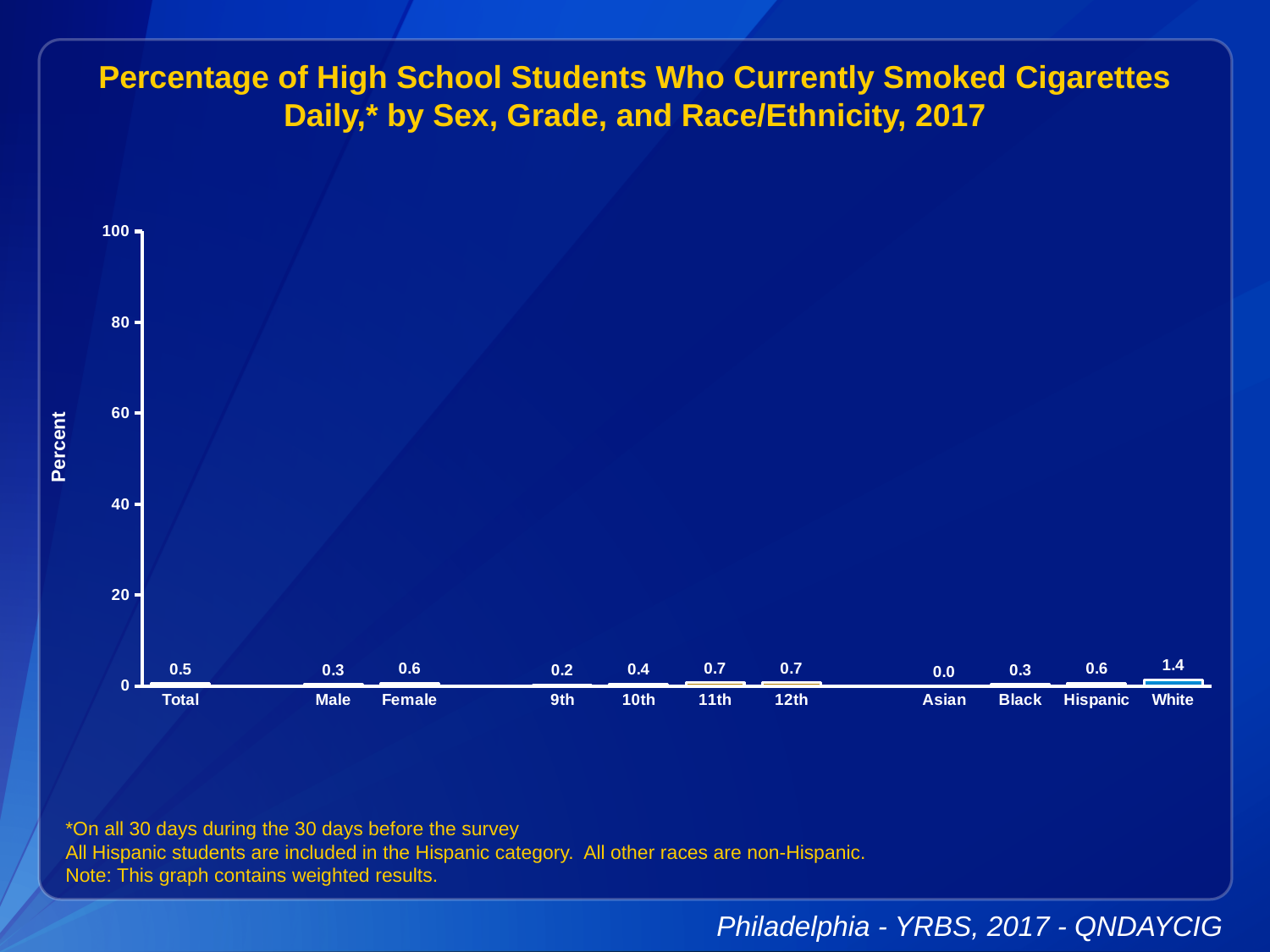
What is the value for Female? 0.6 What is the difference between the values for Female and Male? 0.3 What is the value for Total? 0.5 Is the value for 12th grade greater or less than 20? less What is the value for Asian? 0.0 What is the value for 9th grade? 0.2 Which category has the lowest value? Asian What kind of chart is this? bar chart How many categories are shown on the x axis? 11 What is the label of the y axis? Percent Which category has the highest value? White Which is larger, the value for White or the value for Hispanic? White